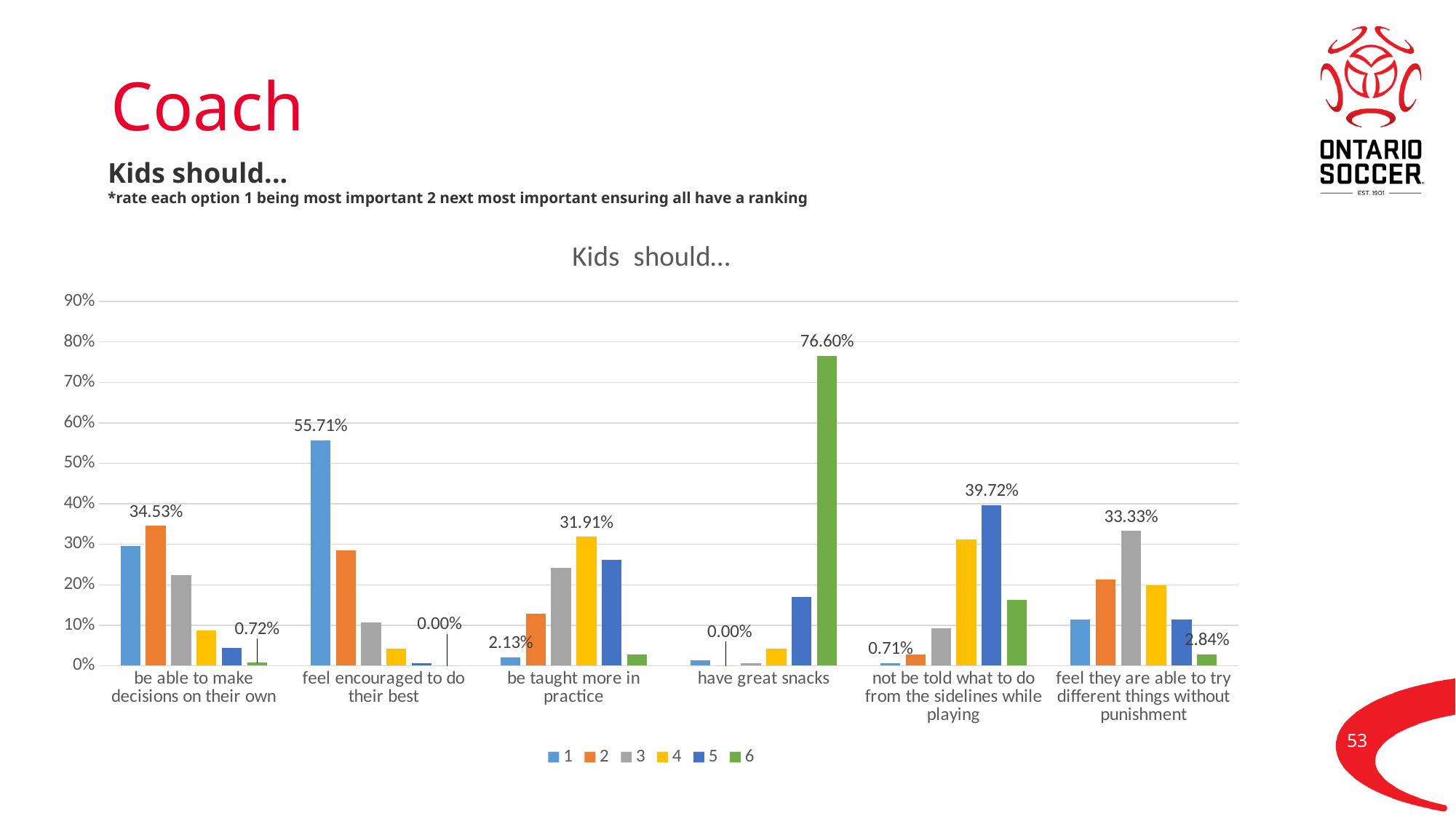
Which is larger: the series 2 value for 'be able to make decisions on their own' or the series 4 value for 'be taught more in practice'? series 2 value for 'be able to make decisions on their own' (34.53%) How many categories are shown on the x axis? 6 What type of chart is shown on the slide? bar chart What is the value for series 3 in the 'feel they are able to try different things without punishment' category? 33.33% What is the value for series 6 in the 'have great snacks' category? 76.60% What is the value for series 1 in the 'feel encouraged to do their best' category? 55.71% How many series does the legend list? 6 Which category has the tallest bar in the chart? have great snacks Is the value for series 3 in the 'be taught more in practice' category greater or less than 20%? greater What is the difference between the series 6 value for 'have great snacks' and the series 1 value for 'feel encouraged to do their best'? 20.89% What is the value for series 5 in the 'not be told what to do from the sidelines while playing' category? 39.72% What is the title of the chart? Kids should...